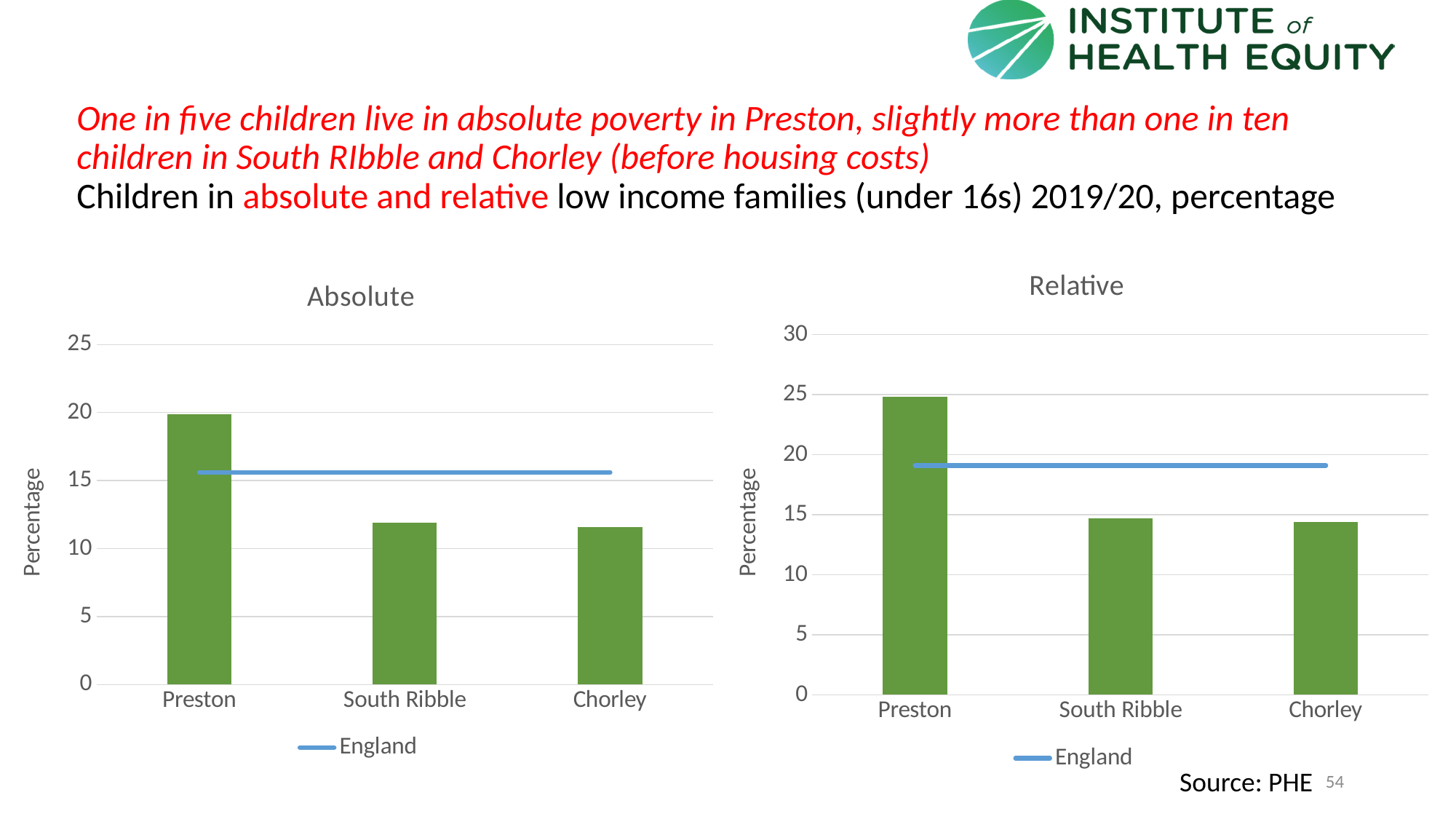
In the Absolute chart, is the value for Preston greater or less than 15? greater What kind of chart is the Absolute chart? bar chart In the Relative chart, is the value for South Ribble greater or less than 20? less What is the y-axis label on the Absolute chart? Percentage In the Relative chart, is the value for Preston greater or less than 20? greater In the Relative chart, which category has the highest value? Preston What entry does the legend of the Relative chart list? England In the Absolute chart, which category has the highest value? Preston In the Absolute chart, which is larger, the value for Preston or the value for South Ribble? Preston How many categories are shown on the x axis of the Relative chart? 3